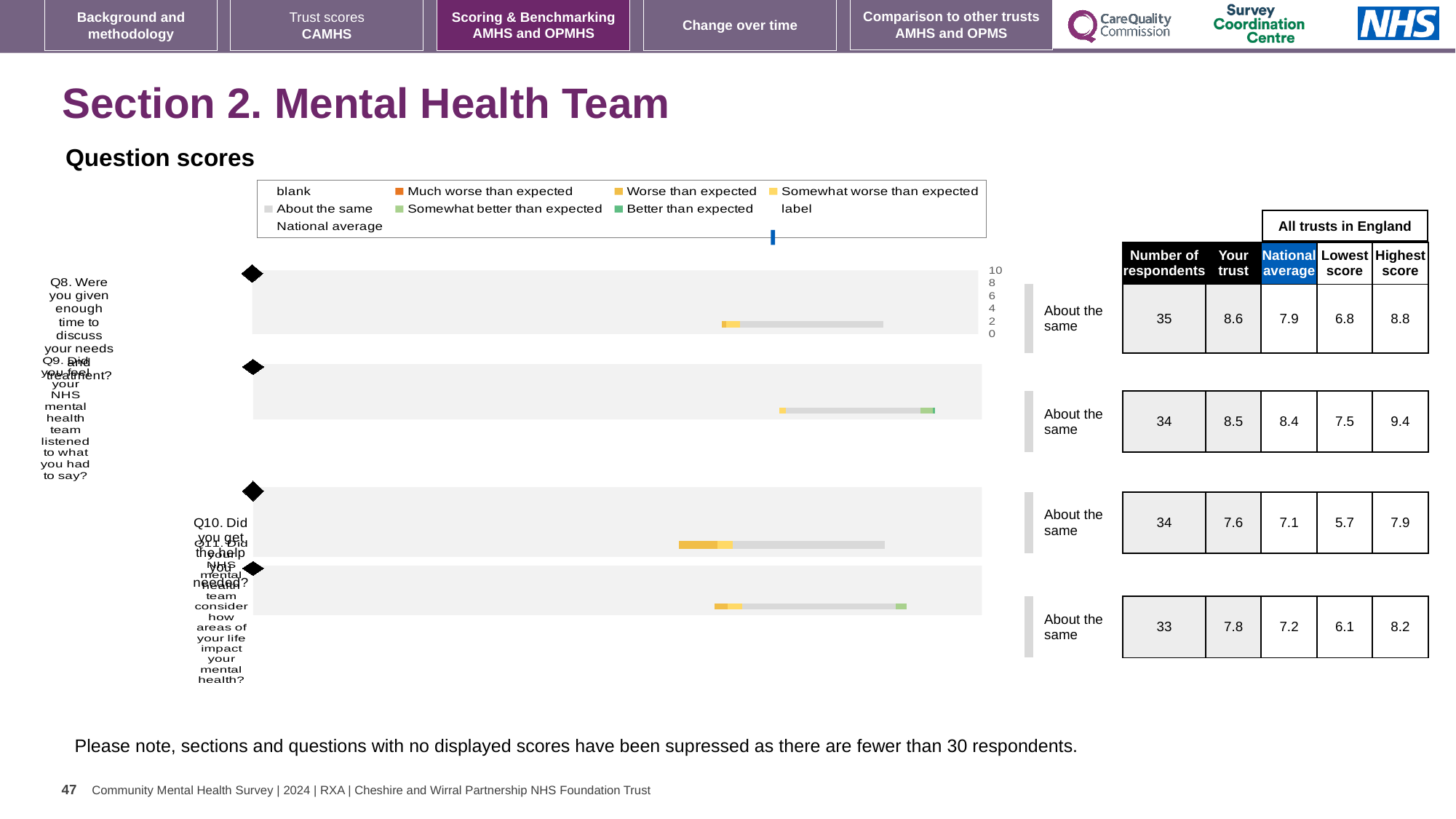
How many entries does the legend of the question scores chart list? 9 In the table beside the chart, what is the highest score among all trusts in England for Q9? 9.4 What type of chart is used to display the question scores on this slide? bar chart In the table beside the chart, how many respondents answered Q11? 33 What is the difference between the 'Your trust' score and the national average for Q8? 0.7 How many questions (Q8 to Q11) are plotted in the question scores chart? 4 What benchmark label is shown next to the chart for Q10? About the same In the table beside the chart, what is the national average for Q9 (Did you feel your NHS mental health team listened to what you had to say)? 8.4 Which question has the lowest 'Your trust' score in the table beside the chart? Q10 Which question has the highest 'Your trust' score in the table beside the chart? Q8 In the table beside the chart, what is the 'Your trust' score for Q8 (Were you given enough time to discuss your needs and treatment)? 8.6 In the table beside the chart, what is the lowest score among all trusts in England for Q10? 5.7